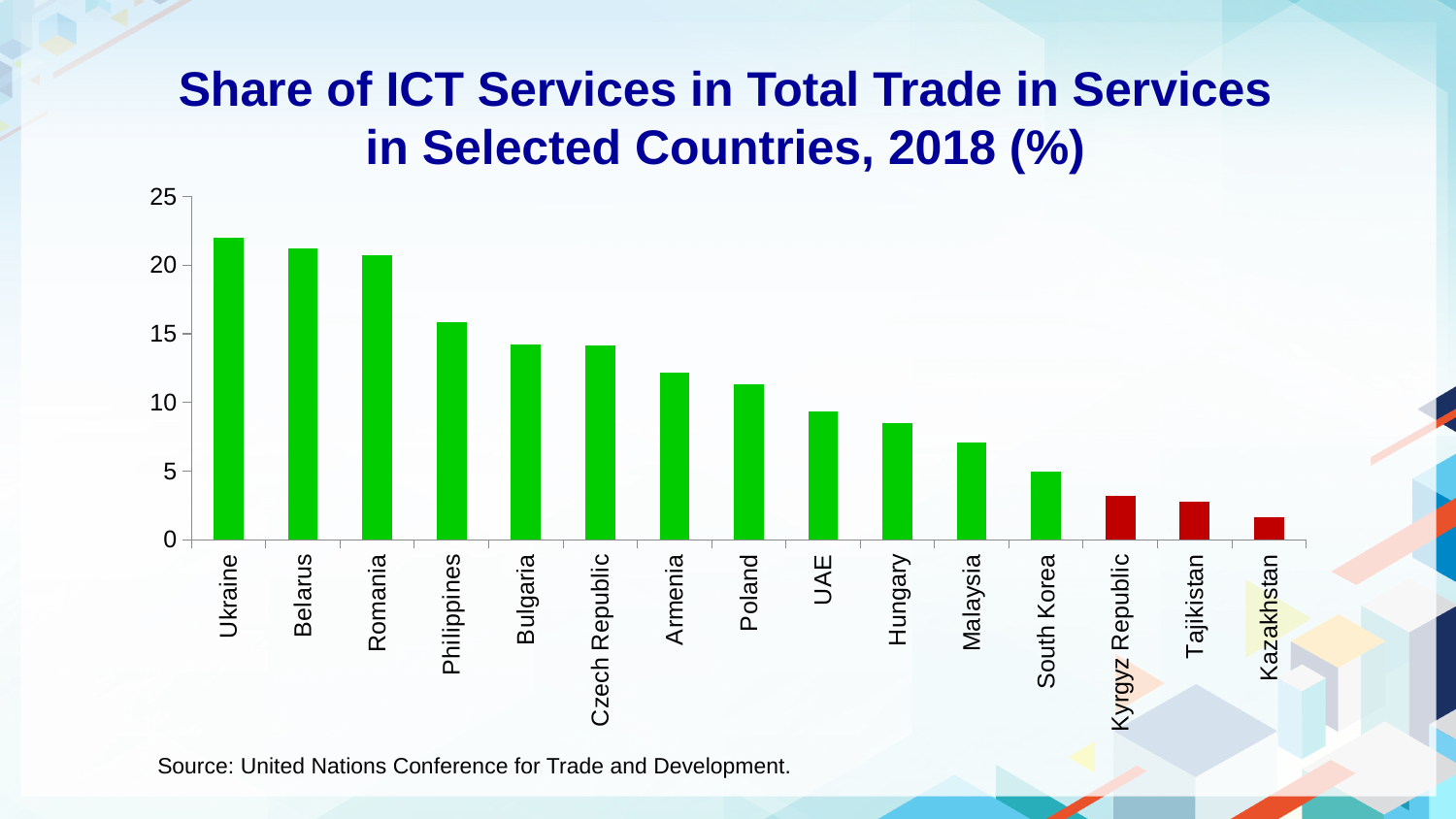
What kind of chart is shown on the slide? Bar chart How many countries are shown on the chart? 15 Which country has the highest share of ICT services in total trade in services? Ukraine Is the value for Ukraine greater or less than 20? greater Do the values rise or fall moving from left to right along the x axis? Fall Is the value for Philippines greater or less than 15? greater Is the value for Poland greater or less than 10? greater Which countries are shown with red bars instead of green? Kyrgyz Republic, Tajikistan, Kazakhstan Which country has the lowest share of ICT services in total trade in services? Kazakhstan Which has a larger share, Philippines or Bulgaria? Philippines